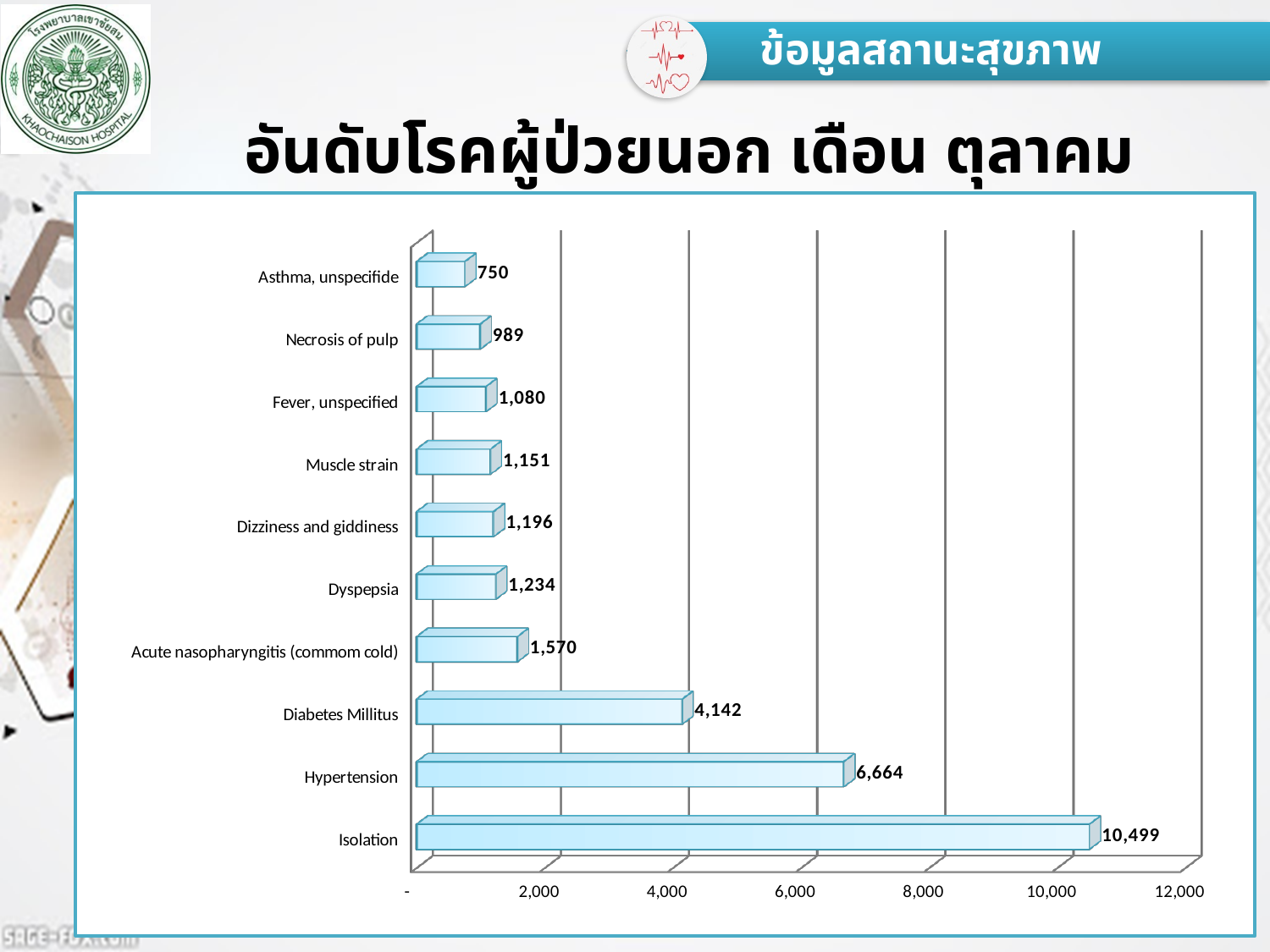
What is the value for Diabetes Millitus? 4,142 What is the value for Asthma, unspecifide? 750 What is the value for Hypertension? 6,664 Which category has the highest value? Isolation What kind of chart is shown on the slide? bar chart What is the value for Isolation? 10,499 How many categories are shown in the chart? 10 What is the difference between the values for Isolation and Hypertension? 3,835 Is the value for Diabetes Millitus greater or less than 4,000? greater What is the value for Acute nasopharyngitis (commom cold)? 1,570 Which category has the lowest value? Asthma, unspecifide Which is larger, the value for Dyspepsia or the value for Muscle strain? Dyspepsia